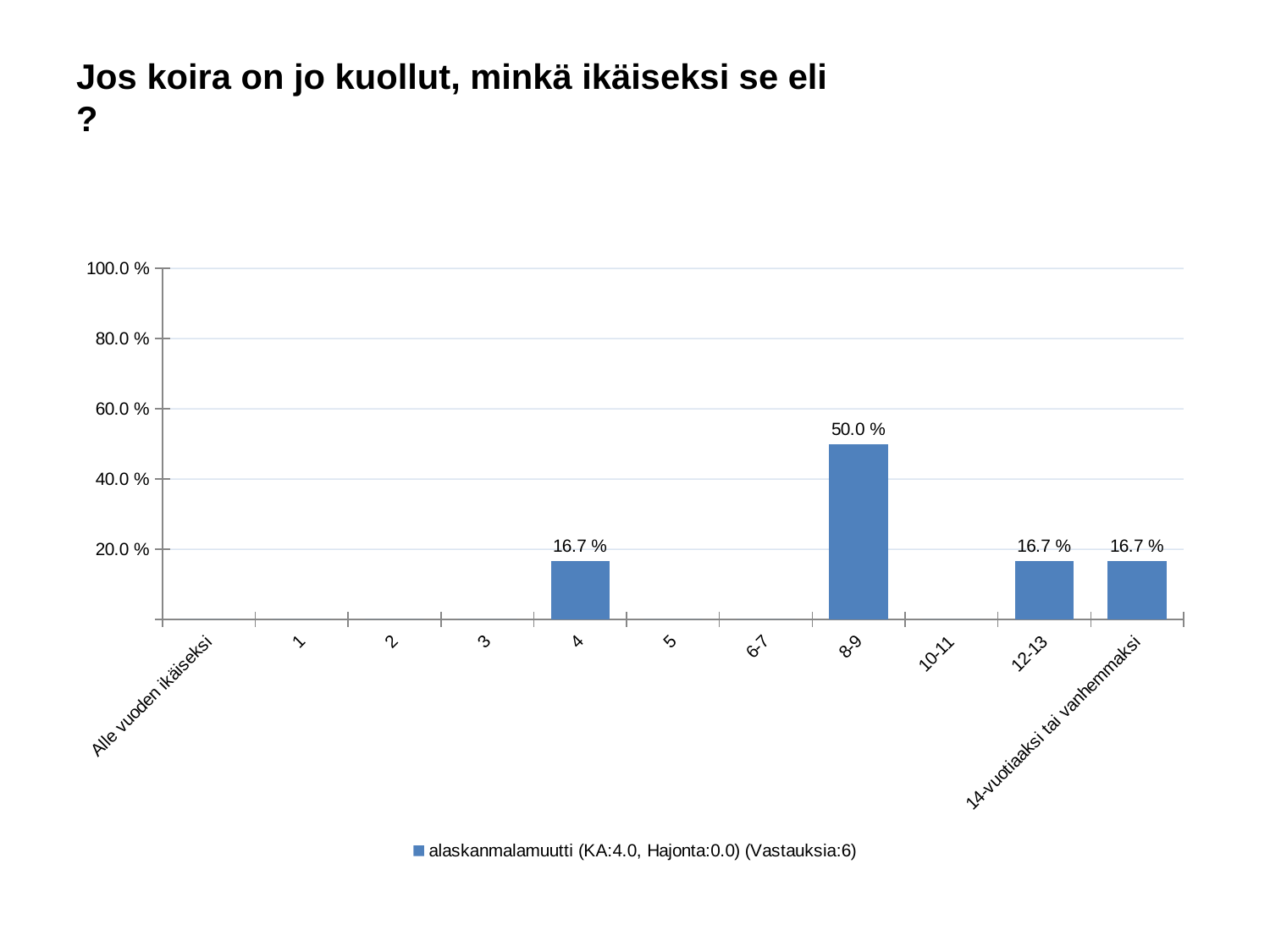
What is the legend entry for the series? alaskanmalamuutti (KA:4.0, Hajonta:0.0) (Vastauksia:6) What kind of chart is shown on the slide? bar chart What is the value for the 12-13 category? 16.7 % How many series does the legend list? 1 How many categories are shown on the x axis? 11 What is the value for the 8-9 category? 50.0 % What is the value for the '14-vuotiaaksi tai vanhemmaksi' category? 16.7 % What is the difference between the value for 8-9 and the value for 12-13? 33.3 % What is the value for the 4 category? 16.7 % Which is larger, the value for 8-9 or the value for 4? 8-9 Which category has the highest value? 8-9 Is the value for 8-9 greater or less than 40.0 %? greater